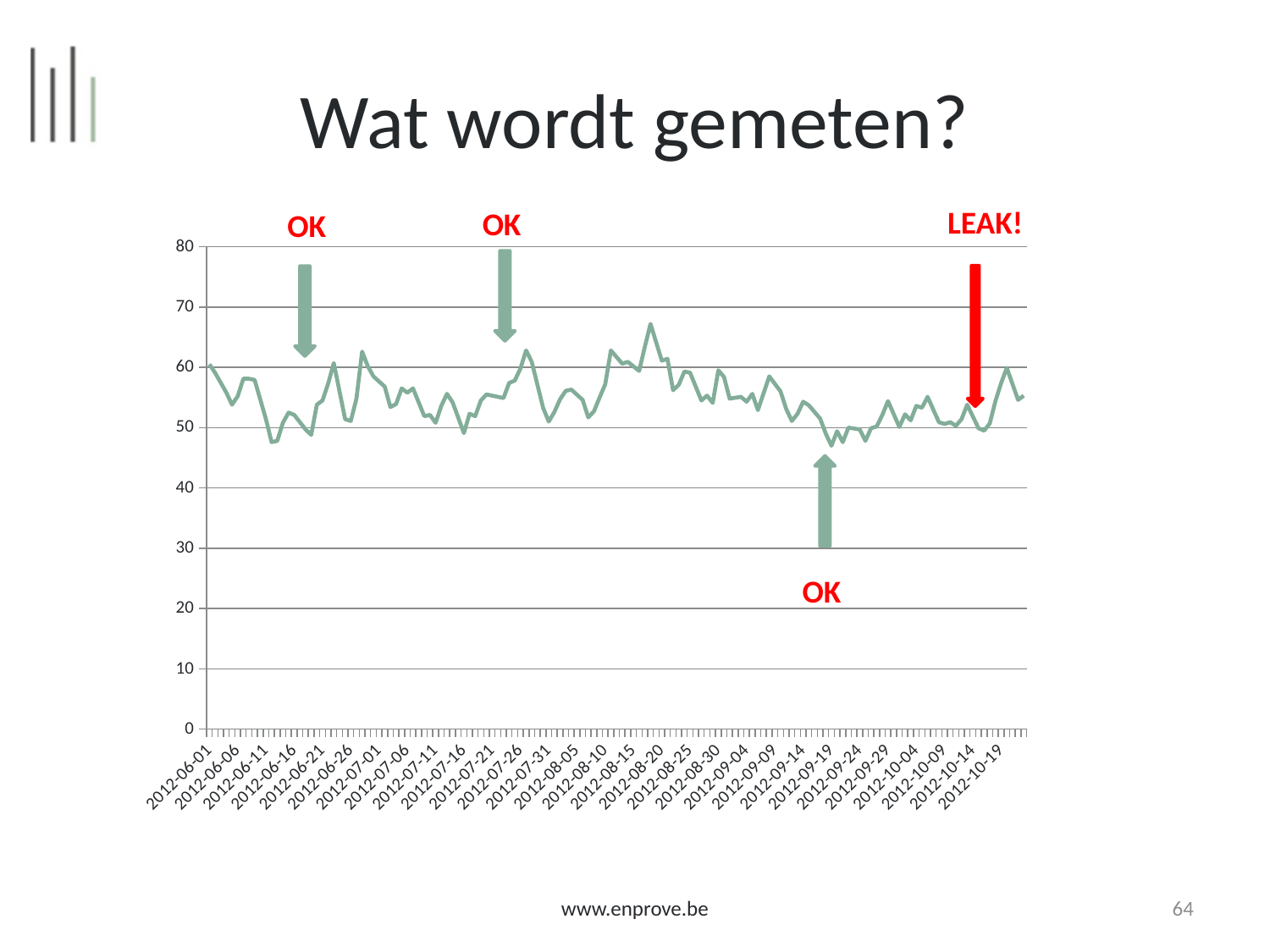
What is the last date label on the x axis? 2012-10-19 Does the line ever drop below 40 on the y axis? no Is the value at 2012-06-01 greater or less than 50? greater Is the lowest point of the line (around 2012-09-19) greater or less than 50? less What is the title of the slide containing the chart? Wat wordt gemeten? How many 'OK' annotations are placed on the chart? 3 What kind of chart is shown on the slide? line chart